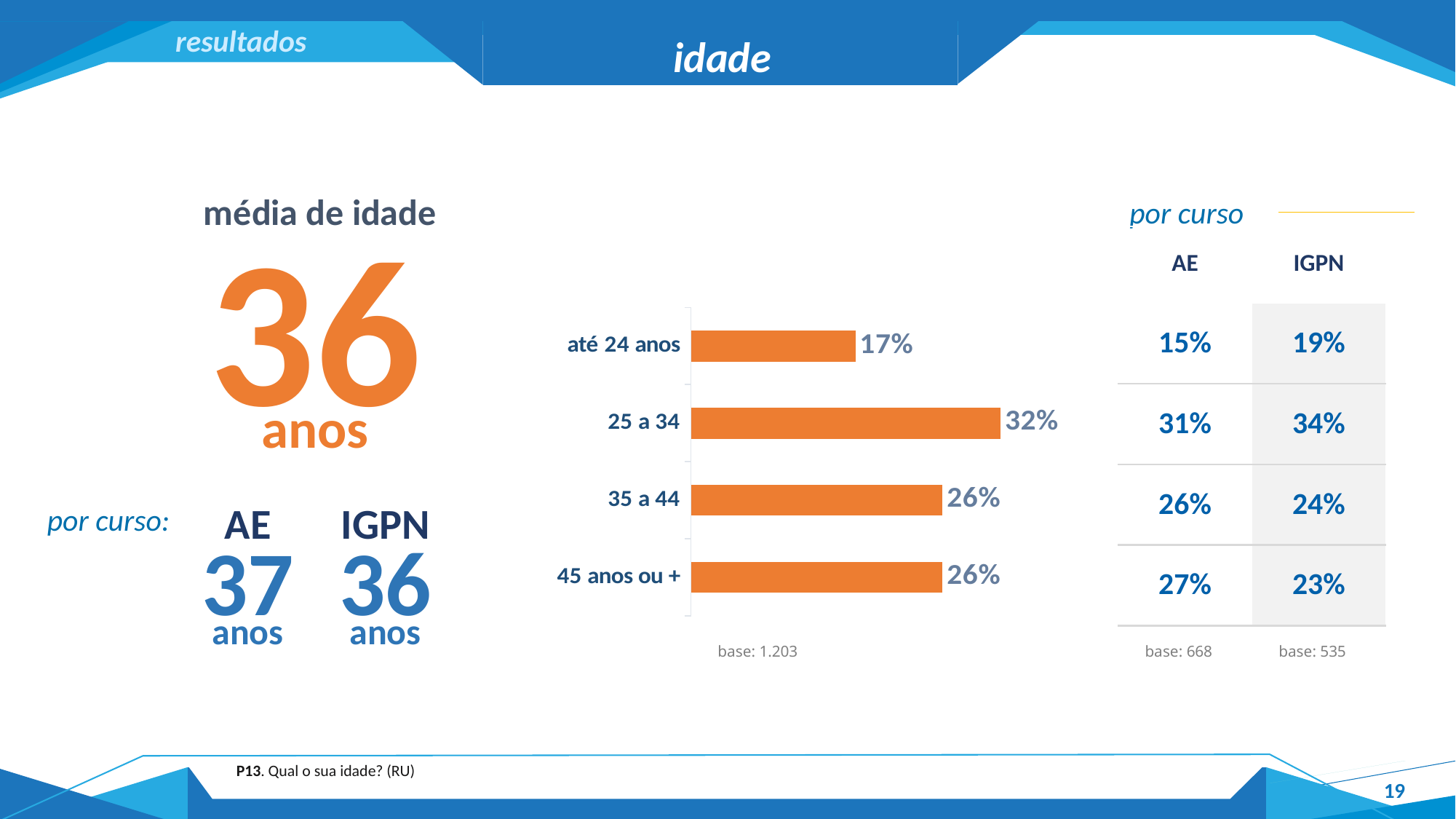
What is the base (sample size) shown under the bar chart? 1.203 What is the value for '35 a 44' in the bar chart? 26% What colour are the bars in the age distribution chart? orange Which age group has the lowest value in the bar chart? até 24 anos What is the value for the '25 a 34' age group in the bar chart? 32% Which is larger in the bar chart: the value for '25 a 34' or the value for '45 anos ou +'? 25 a 34 What is the value for 'até 24 anos' in the bar chart? 17% What is the difference between the '25 a 34' and 'até 24 anos' values in the bar chart? 15% What kind of chart is used to show the age distribution? bar chart How many age groups are shown in the bar chart? 4 Which age group has the highest value in the bar chart? 25 a 34 What is the difference between the '35 a 44' and '45 anos ou +' values in the bar chart? 0%